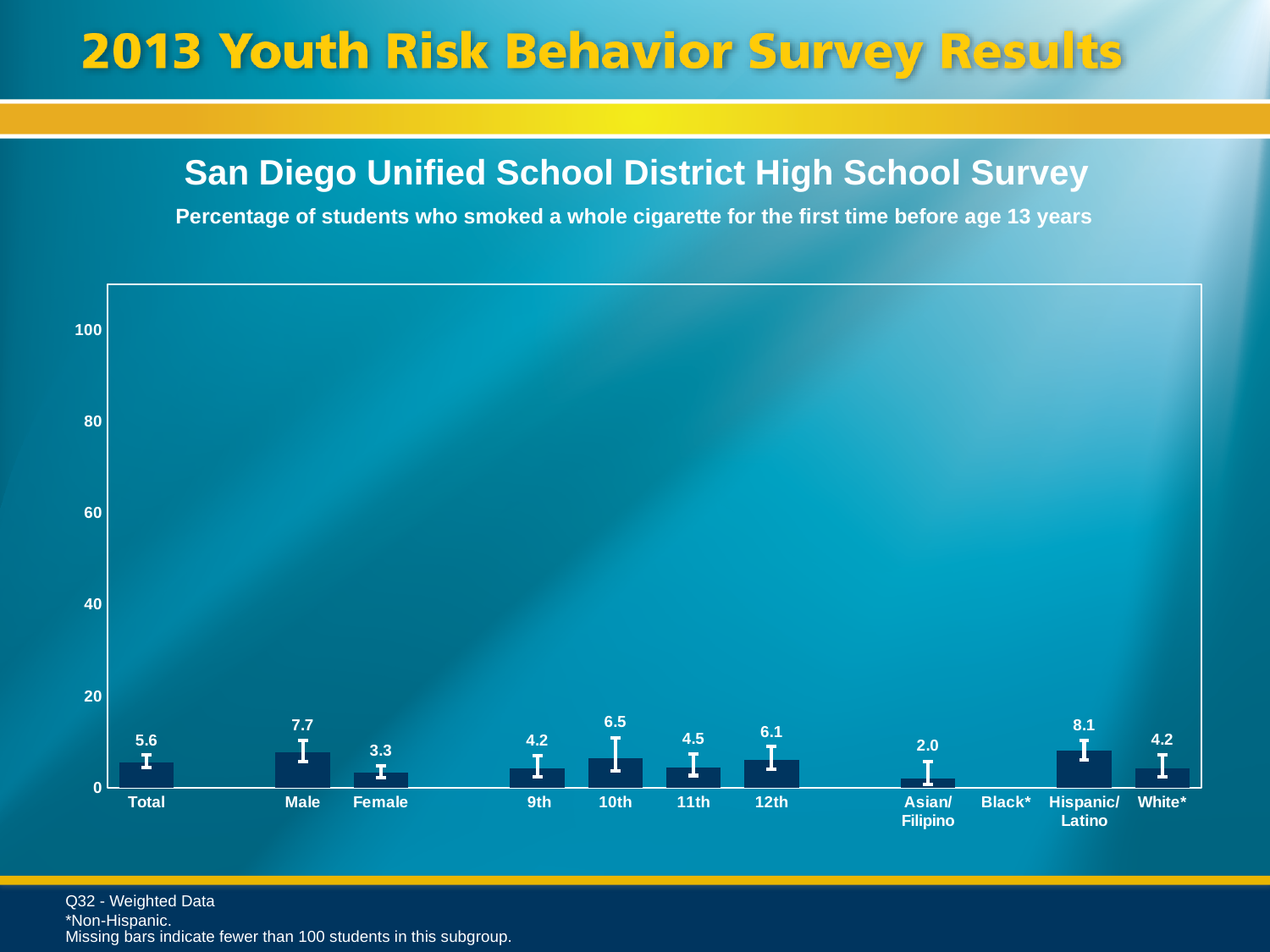
What is the value for Asian/Filipino? 2.0 What is the value for Female? 3.3 What is the value for Total? 5.6 Which is larger, the value for 12th grade or the value for 11th grade? 12th Which category has the highest value? Hispanic/Latino Which category has the lowest value among those with a bar shown? Asian/Filipino What is the value for Male? 7.7 What is the value for 10th grade? 6.5 Is the value for Hispanic/Latino greater or less than 20? less Which category has no bar shown? Black* What kind of chart is shown? bar chart What is the difference between the Male and Female values? 4.4